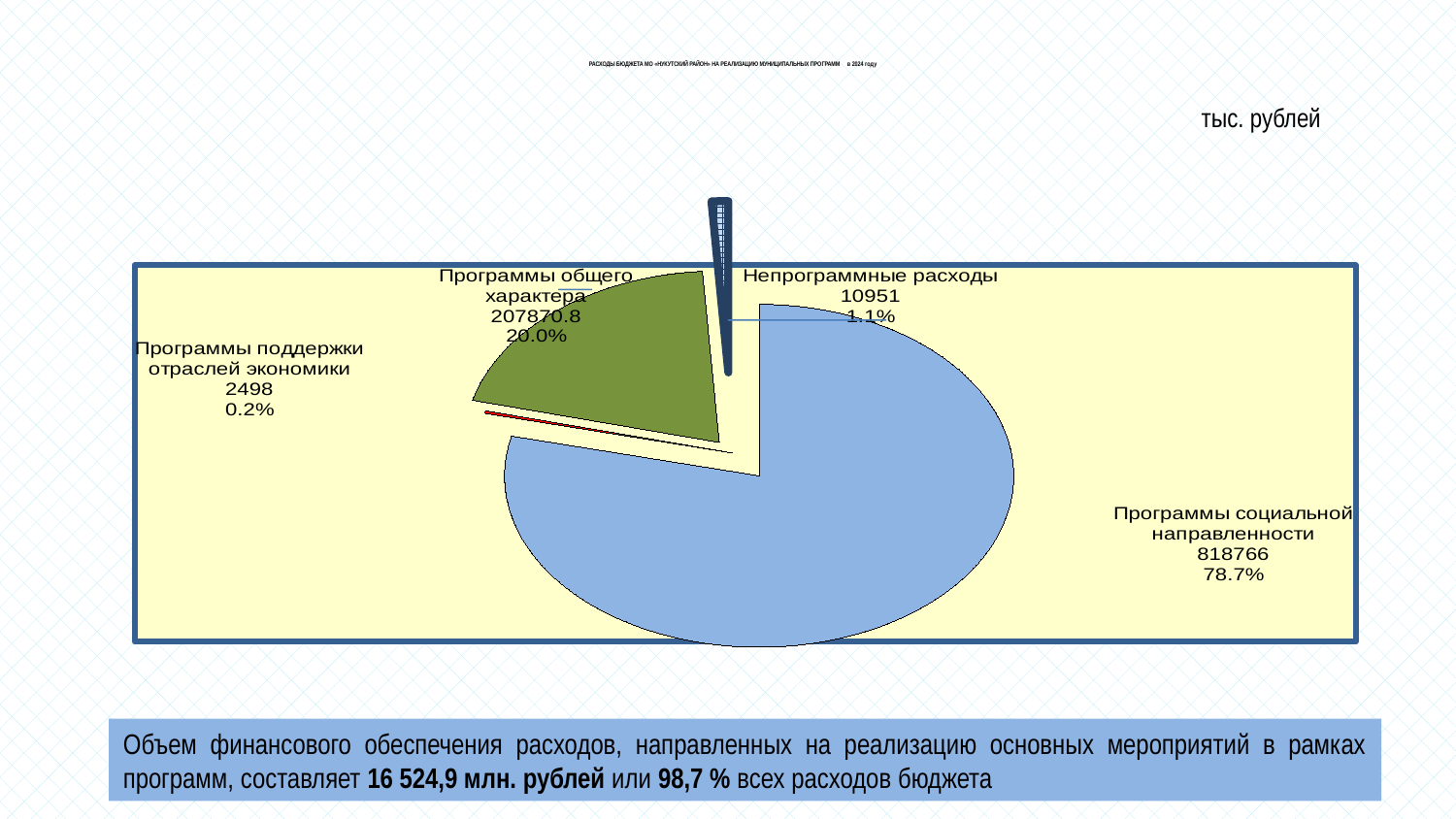
What is the value for Непрограммные расходы? 10951 How many slices does the pie chart have? 4 What share of the pie does Программы общего характера take? 20.0% What is the value for Программы общего характера? 207870.8 Which category has the largest slice of the pie? Программы социальной направленности What kind of chart is shown on the slide? pie chart What is the value for Программы социальной направленности? 818766 Which is larger, Непрограммные расходы or Программы поддержки отраслей экономики? Непрограммные расходы What unit of measurement is indicated for the chart values? тыс. рублей Which category has the smallest slice of the pie? Программы поддержки отраслей экономики What share of the pie does Программы социальной направленности take? 78.7% What is the value for Программы поддержки отраслей экономики? 2498